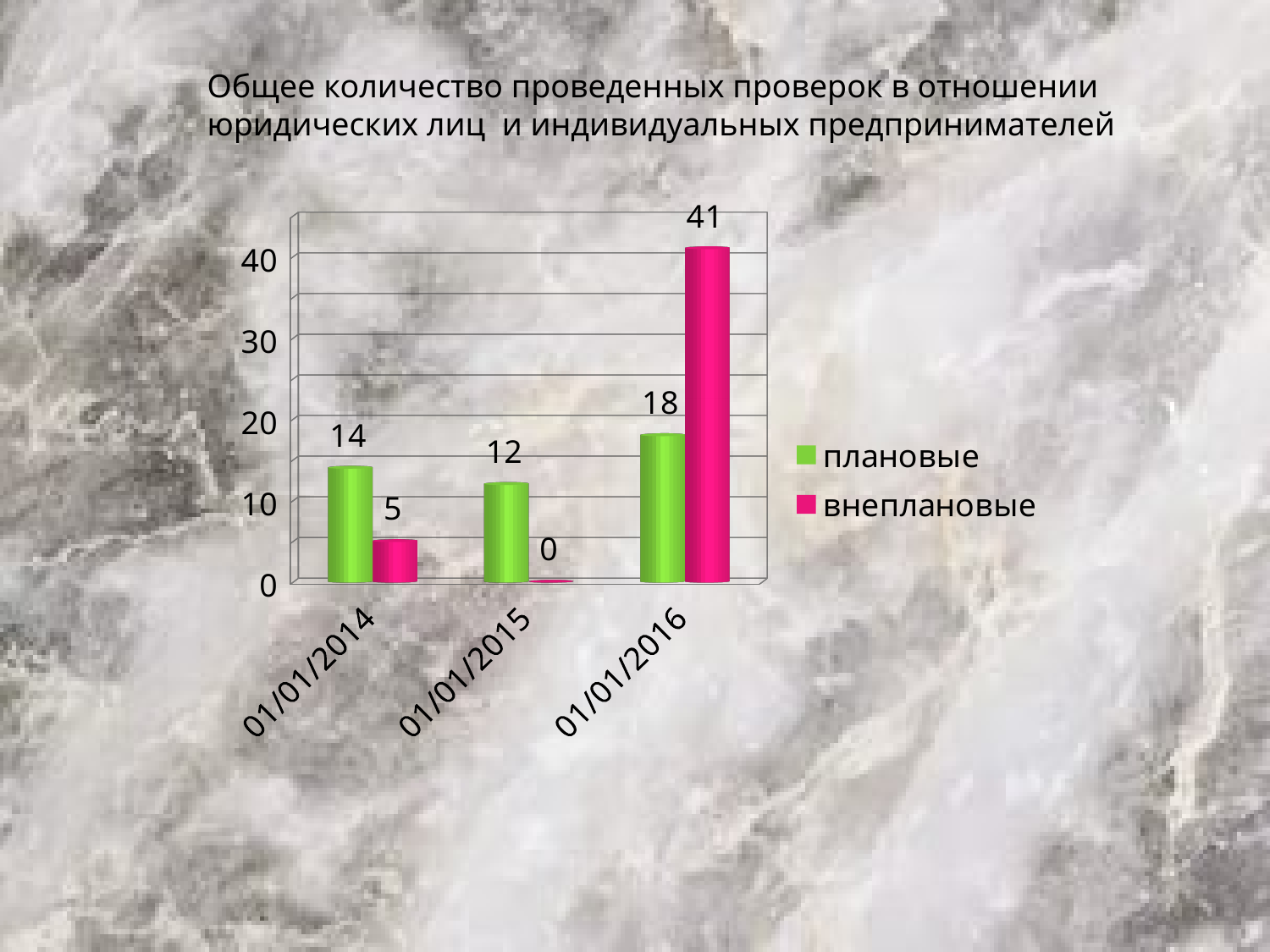
What is the value for внеплановые on 01/01/2016? 41 What kind of chart is shown? bar chart Which is larger on 01/01/2014: плановые or внеплановые? плановые What is the value for плановые on 01/01/2014? 14 What is the difference between внеплановые and плановые on 01/01/2016? 23 What is the value for внеплановые on 01/01/2015? 0 How many dates are shown on the x axis? 3 On which date is the value for внеплановые highest? 01/01/2016 Does the value for внеплановые rise or fall from 01/01/2015 to 01/01/2016? rise On which date is the value for плановые lowest? 01/01/2015 How many series does the legend list? 2 Which colour represents the внеплановые series? pink